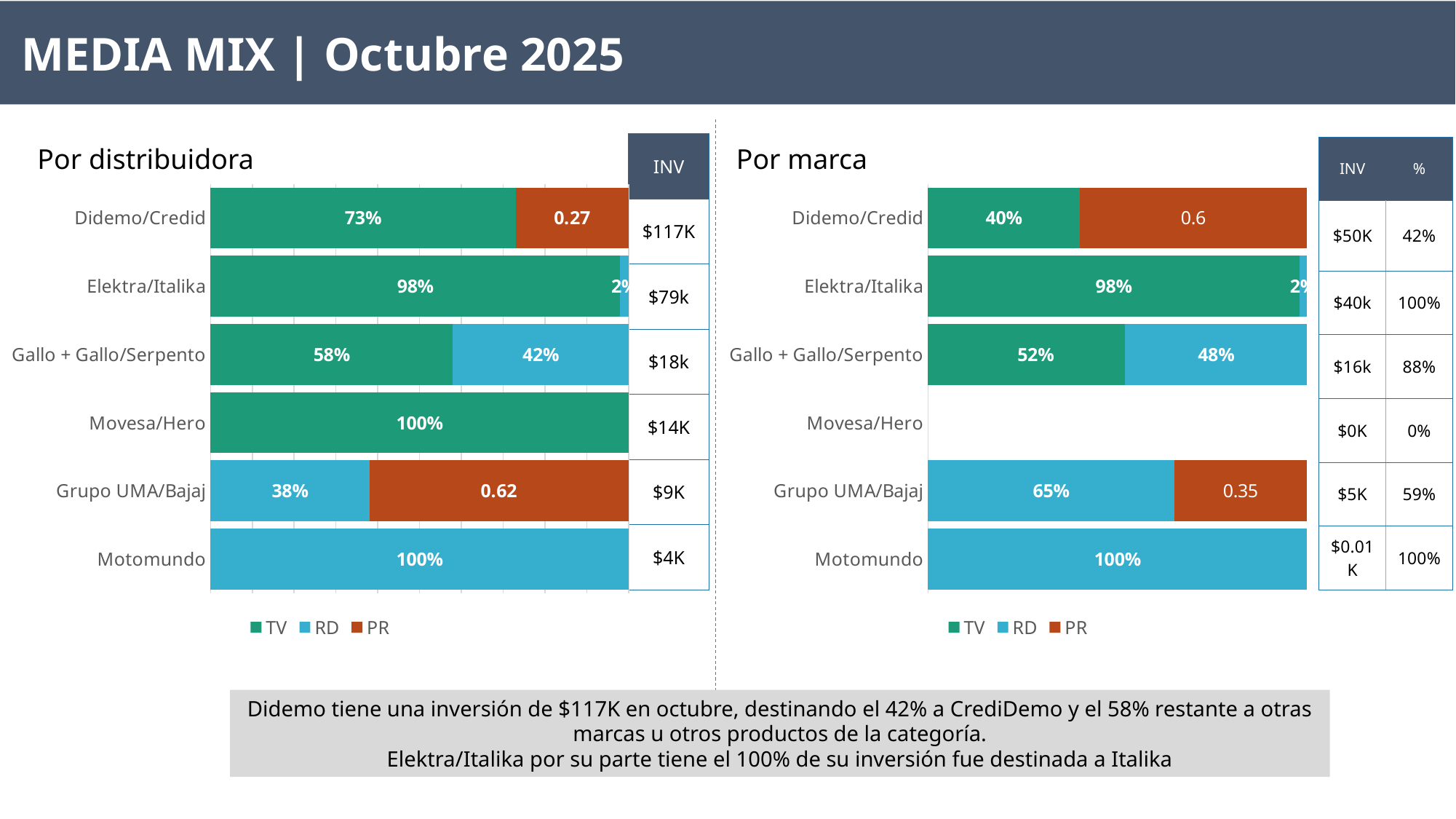
In the 'Por distribuidora' chart, which category has the highest TV share? Movesa/Hero How many series does the legend of the 'Por marca' chart list? 3 In the 'Por distribuidora' chart, what is the RD share for Gallo + Gallo/Serpento? 42% In the 'Por distribuidora' chart, what is the difference between the TV share of Elektra/Italika and the TV share of Gallo + Gallo/Serpento? 40% In the 'Por marca' chart, what is the TV share for Didemo/Credid? 40% In the 'Por distribuidora' chart, what is the TV share for Didemo/Credid? 73% What kind of chart is the 'Por distribuidora' chart? Stacked bar chart In the 'Por marca' chart, what is the RD share for Grupo UMA/Bajaj? 65% In the 'Por distribuidora' chart, what is the PR value labelled for Grupo UMA/Bajaj? 0.62 How many categories are shown on the y axis of the 'Por distribuidora' chart? 6 In the 'Por marca' chart, which is larger for Gallo + Gallo/Serpento: the TV share or the RD share? TV In the 'Por marca' chart, what is the TV share for Gallo + Gallo/Serpento? 52%